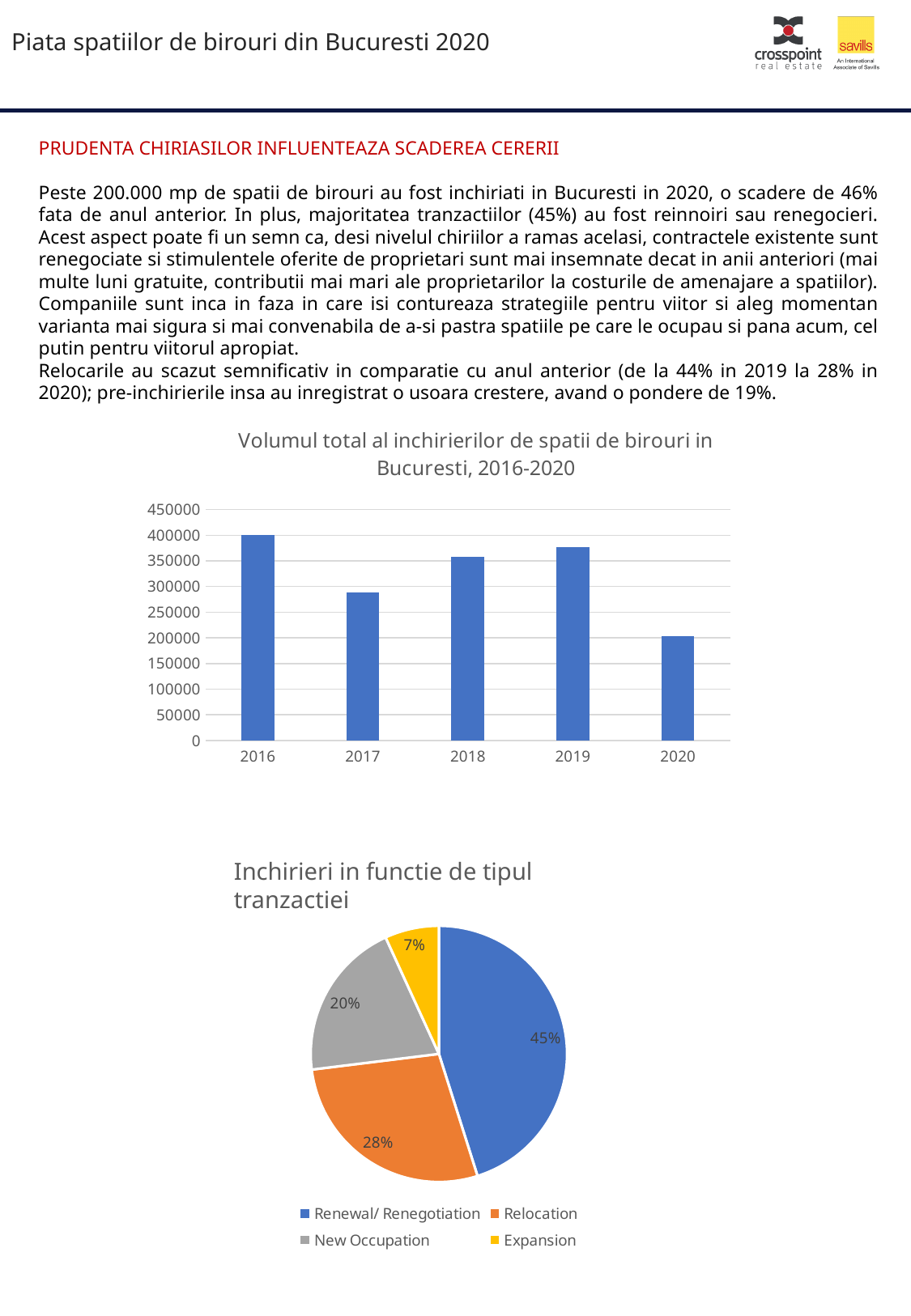
In the bar chart 'Volumul total al inchirierilor de spatii de birouri in Bucuresti, 2016-2020', which year has the highest value? 2016 In the pie chart 'Inchirieri in functie de tipul tranzactiei', what is the difference between the shares of Relocation and New Occupation? 8% In the bar chart 'Volumul total al inchirierilor de spatii de birouri in Bucuresti, 2016-2020', is the value for 2020 greater or less than 250000? less In the bar chart 'Volumul total al inchirierilor de spatii de birouri in Bucuresti, 2016-2020', is the value for 2019 greater or less than 350000? greater In the bar chart 'Volumul total al inchirierilor de spatii de birouri in Bucuresti, 2016-2020', which year has the lowest value? 2020 In the bar chart 'Volumul total al inchirierilor de spatii de birouri in Bucuresti, 2016-2020', which is larger, the value for 2017 or the value for 2018? 2018 In the bar chart 'Volumul total al inchirierilor de spatii de birouri in Bucuresti, 2016-2020', is the value for 2017 greater or less than 300000? less How many years are shown in the bar chart 'Volumul total al inchirierilor de spatii de birouri in Bucuresti, 2016-2020'? 5 In the pie chart 'Inchirieri in functie de tipul tranzactiei', what share does Relocation have? 28% In the pie chart 'Inchirieri in functie de tipul tranzactiei', what share does Renewal/ Renegotiation have? 45% What kind of chart is the top chart on the slide? bar chart In the pie chart 'Inchirieri in functie de tipul tranzactiei', which category has the smallest share? Expansion